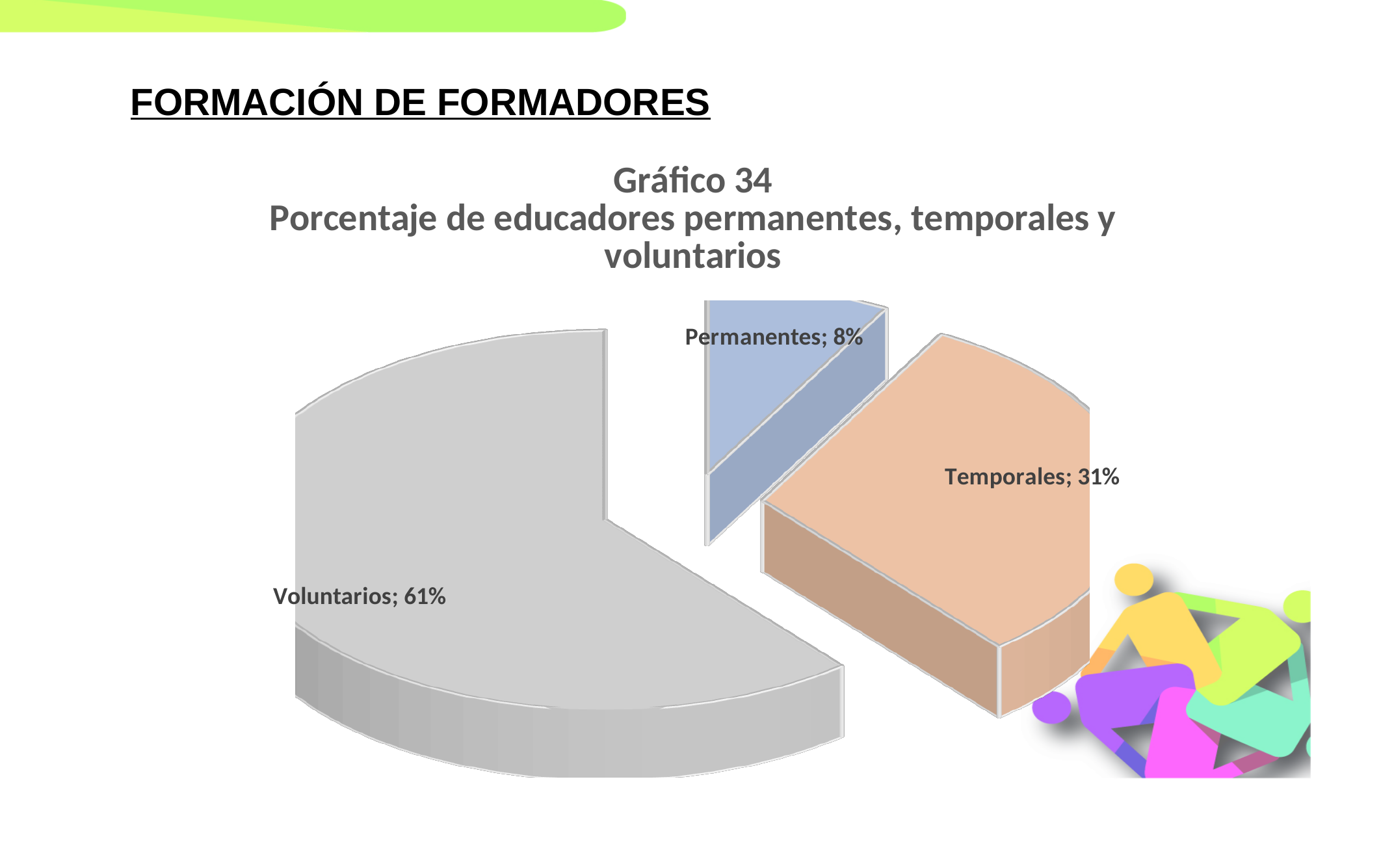
What percentage of educators are Temporales? 31% What kind of chart is shown on the slide? Pie chart What colour is the Temporales slice? Orange What is the title of the chart? Gráfico 34 Porcentaje de educadores permanentes, temporales y voluntarios How many categories are shown in the pie chart? 3 What percentage of educators are Voluntarios? 61% What is the difference in percentage points between Voluntarios and Temporales? 30 Which is larger, the share for Temporales or the share for Permanentes? Temporales Which category has the largest share of the pie? Voluntarios What percentage of educators are Permanentes? 8% Which category has the smallest share of the pie? Permanentes What is the difference in percentage points between Temporales and Permanentes? 23